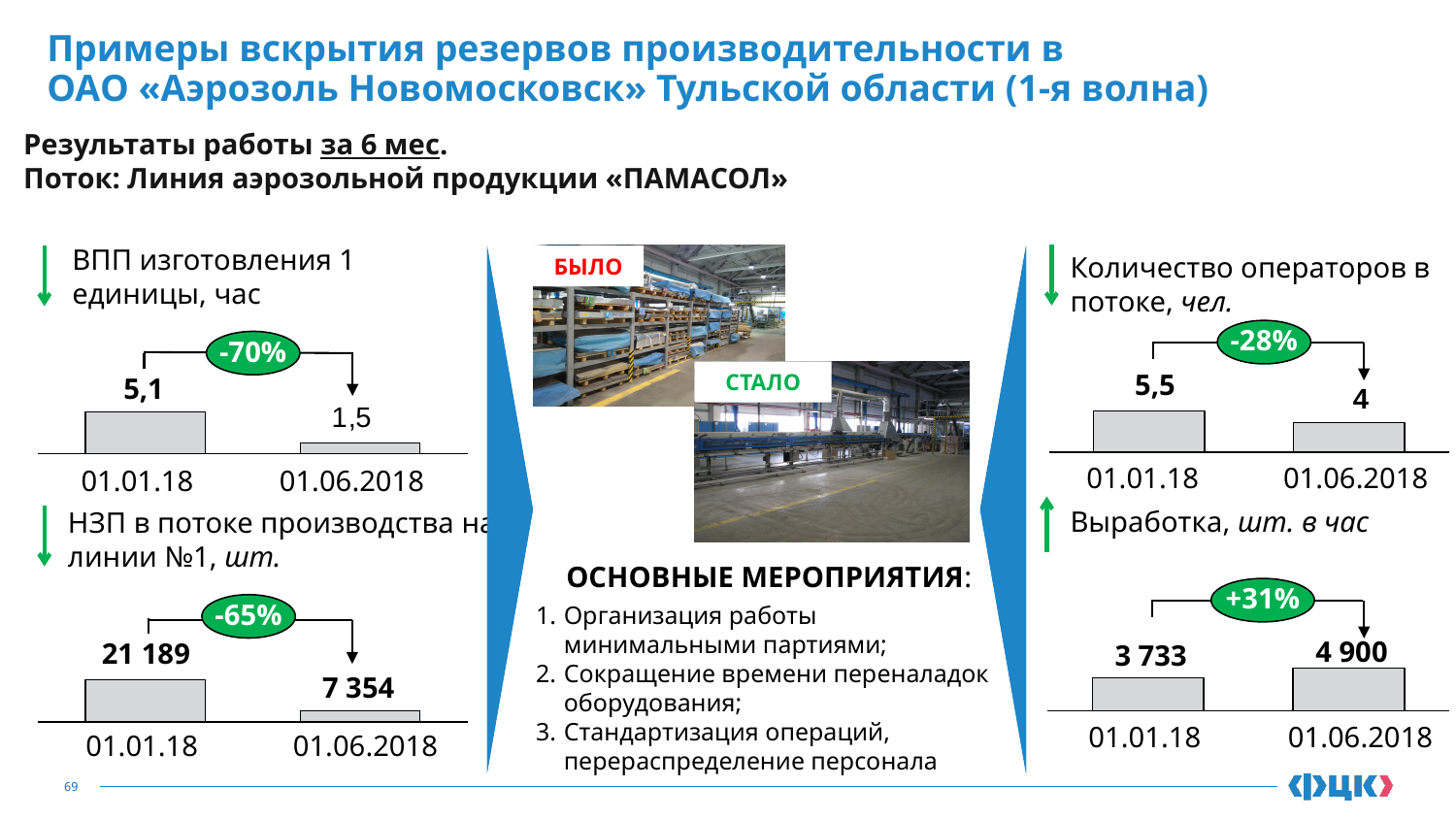
On the chart 'Количество операторов в потоке, чел.', what is the value for 01.06.2018? 4 On the chart 'ВПП изготовления 1 единицы, час', what is the value for 01.06.2018? 1,5 On the chart 'Выработка, шт. в час', what is the value for 01.06.2018? 4 900 On the chart 'Количество операторов в потоке, чел.', what is the value for 01.01.18? 5,5 On the chart 'НЗП в потоке производства на линии №1, шт.', what is the value for 01.01.18? 21 189 On the chart 'НЗП в потоке производства на линии №1, шт.', what is the value for 01.06.2018? 7 354 On the chart 'ВПП изготовления 1 единицы, час', what percentage change is shown between the two bars? -70% What type of chart is used for 'Количество операторов в потоке, чел.'? Bar chart On the chart 'НЗП в потоке производства на линии №1, шт.', what is the difference between the 01.01.18 and 01.06.2018 values? 13 835 On the chart 'ВПП изготовления 1 единицы, час', what is the value for 01.01.18? 5,1 On the chart 'Выработка, шт. в час', which date has the higher value, 01.01.18 or 01.06.2018? 01.06.2018 On the chart 'Выработка, шт. в час', what is the difference between the 01.06.2018 and 01.01.18 values? 1 167